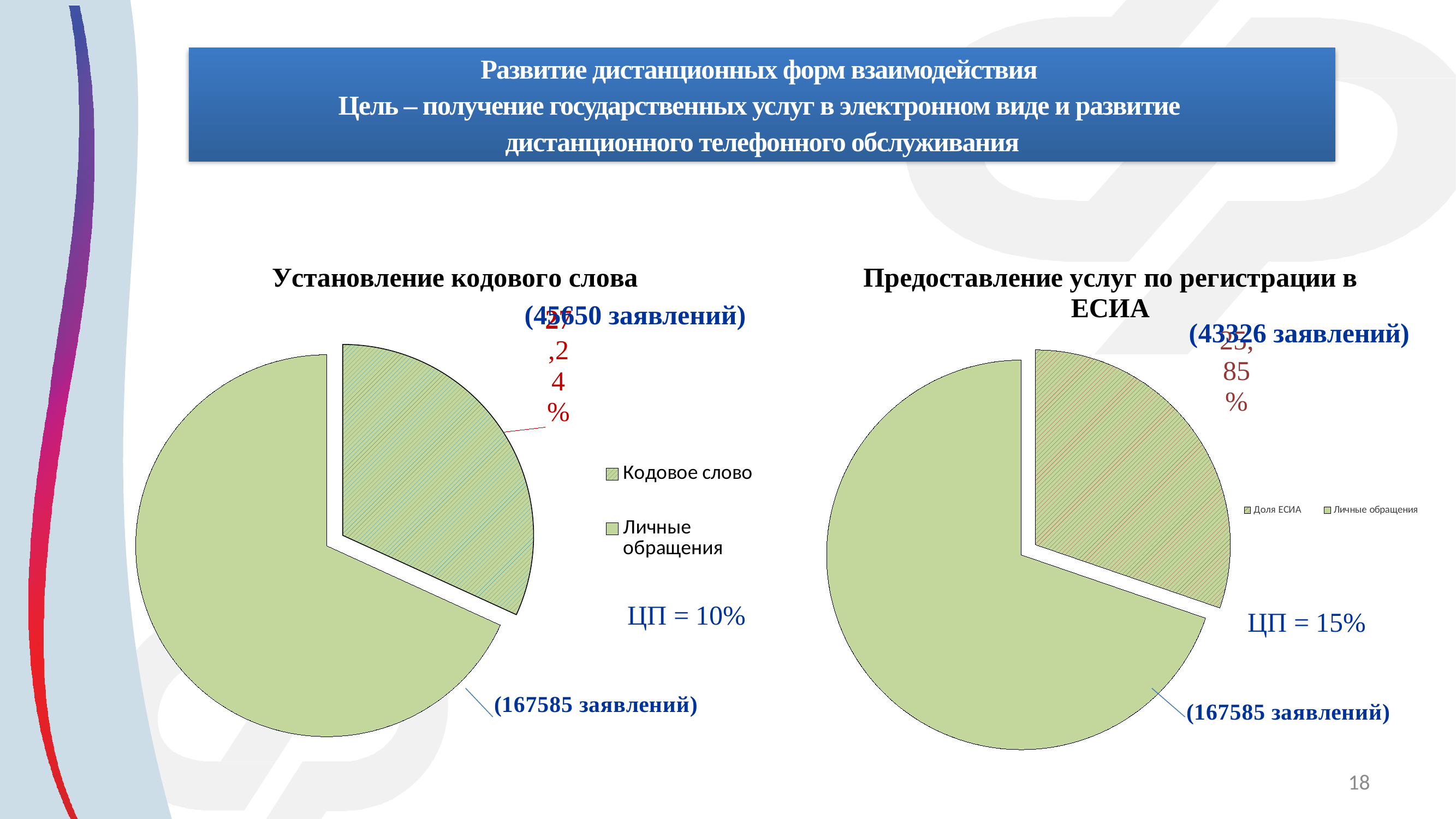
In the left chart "Установление кодового слова", what target value (ЦП) is shown next to the chart? ЦП = 10% In the left chart "Установление кодового слова", what number of applications is annotated for the "Кодовое слово" slice? 45650 заявлений In the left chart "Установление кодового слова", how many slices does the pie have? 2 What kind of chart is the left chart titled "Установление кодового слова"? Pie chart In the left chart "Установление кодового слова", how many entries does the legend list? 2 In the right chart "Предоставление услуг по регистрации в ЕСИА", how many entries does the legend list? 2 In the left chart "Установление кодового слова", which slice is larger: "Кодовое слово" or "Личные обращения"? Личные обращения What kind of chart is the right chart titled "Предоставление услуг по регистрации в ЕСИА"? Pie chart In the right chart "Предоставление услуг по регистрации в ЕСИА", which slice is the largest? Личные обращения In the right chart "Предоставление услуг по регистрации в ЕСИА", what target value (ЦП) is shown next to the chart? ЦП = 15% In the right chart "Предоставление услуг по регистрации в ЕСИА", which slice is the smallest? Доля ЕСИА In the right chart "Предоставление услуг по регистрации в ЕСИА", what number of applications is annotated for the "Доля ЕСИА" slice? 43326 заявлений